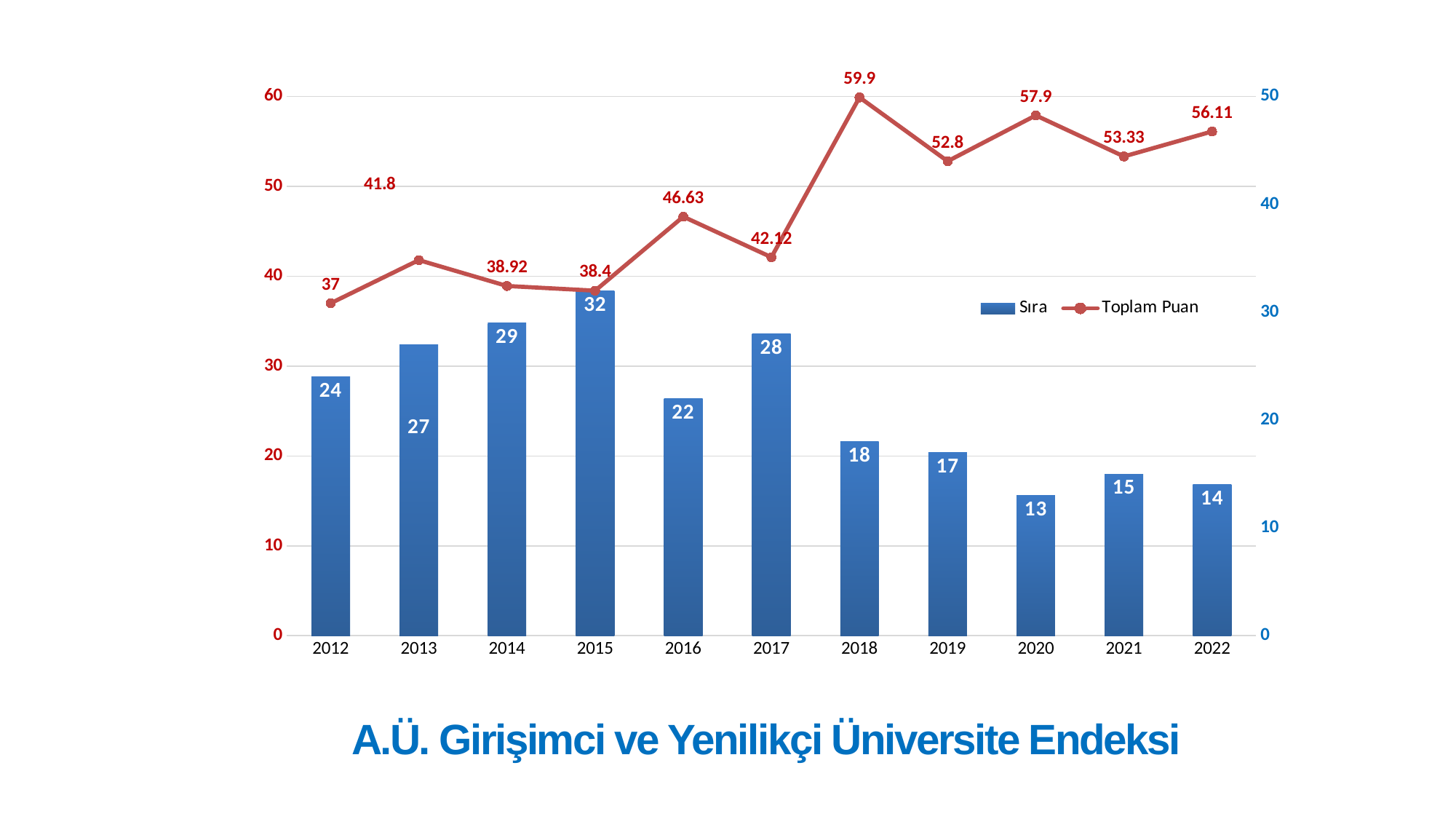
How many series does the legend list? 2 What is the Toplam Puan value for 2018? 59.9 Which year has the lowest Sıra value? 2020 What is the Toplam Puan value for 2022? 56.11 What is the title shown below the chart? A.Ü. Girişimci ve Yenilikçi Üniversite Endeksi How many years are shown on the x axis? 11 Which year has the highest Toplam Puan? 2018 What kind of chart is shown on the slide? Combined bar and line chart What is the Sıra value for 2015? 32 Do the Sıra bar values generally rise or fall from 2017 to 2020? Fall What is the difference between the Sıra values for 2015 and 2022? 18 Which is larger, the Toplam Puan for 2013 or for 2014? 2013